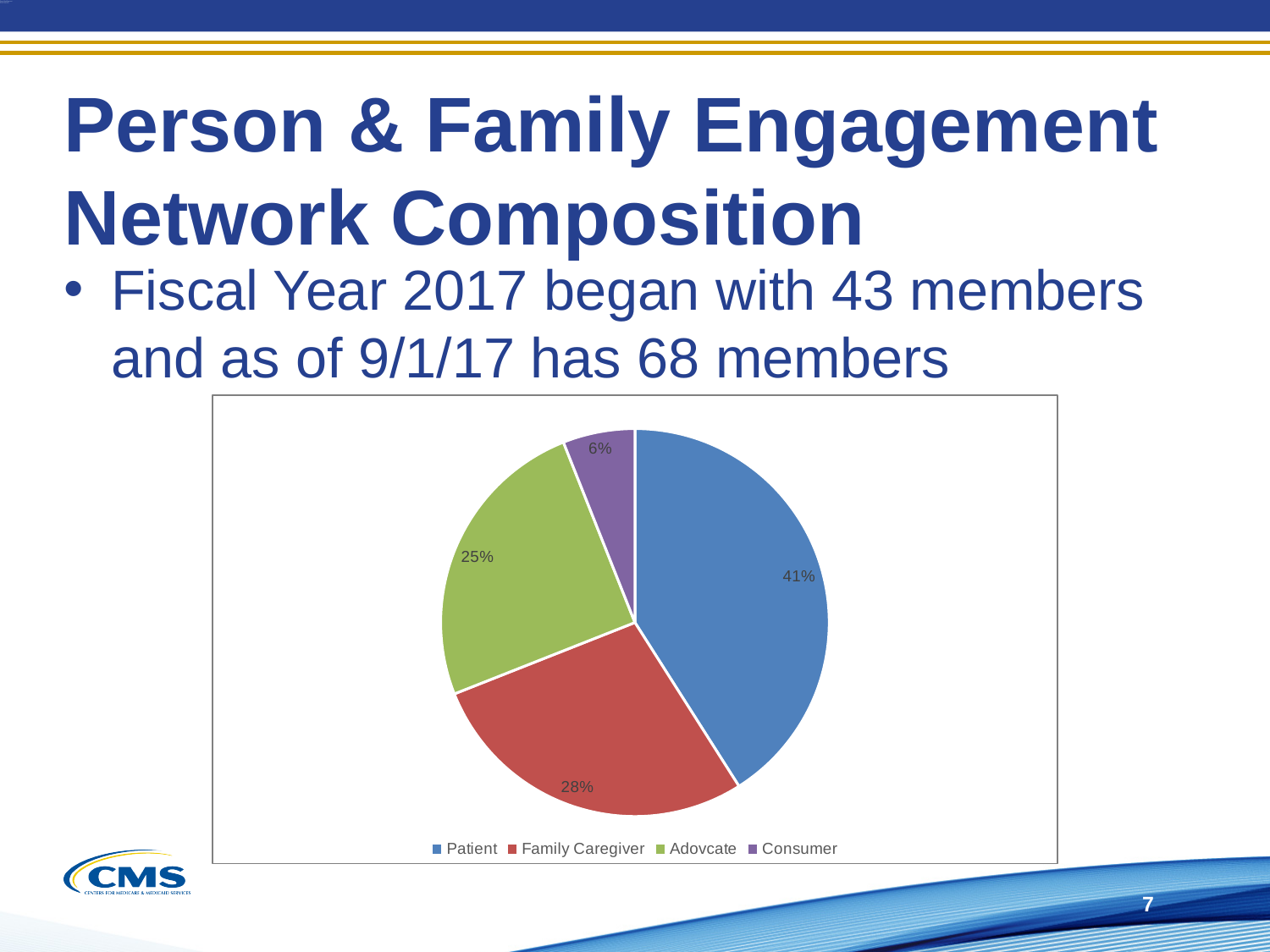
Which is larger, the Family Caregiver slice or the Adovcate slice? Family Caregiver What percentage of the network is Consumer? 6% Which category has the smallest share of the pie? Consumer How many categories does the pie chart show? 4 What percentage of the network is Patient? 41% What percentage of the network is Family Caregiver? 28% What percentage of the network is Adovcate? 25% What is the difference in percentage points between the Patient and Family Caregiver slices? 13 Which category has the largest share of the pie? Patient What kind of chart is shown on the slide? pie chart What is the combined share of the Adovcate and Consumer slices? 31% What colour is the Patient slice? blue